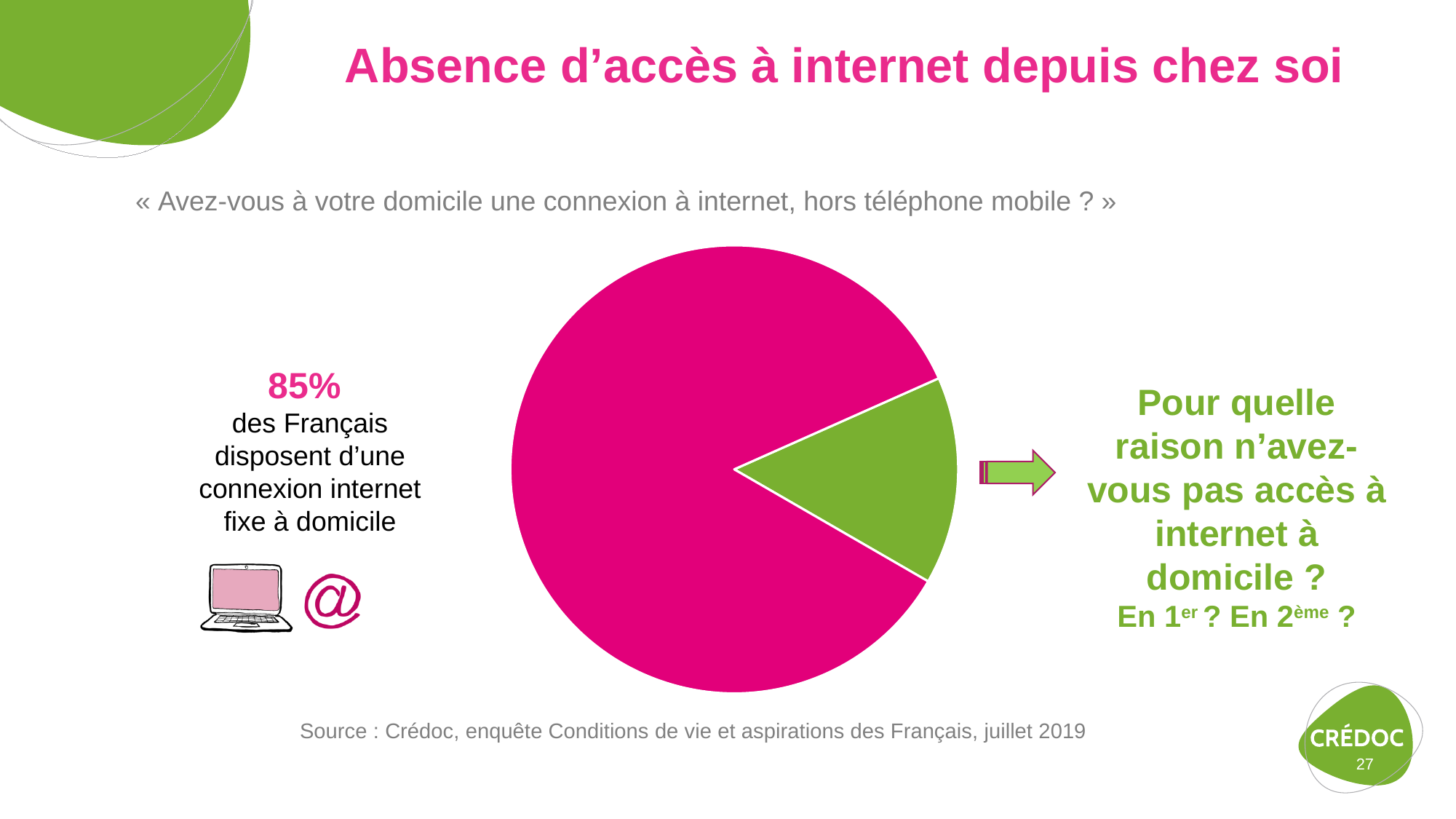
Which slice of the pie chart is the smallest? the green slice Which slice of the pie chart represents the French who have a fixed internet connection at home? the pink slice How many slices does the pie chart have? 2 What kind of chart is shown on the slide? pie chart What colour is the slice representing people without internet access at home? green Which slice of the pie chart is larger, the pink one or the green one? the pink one According to the slide, what share of French people have a fixed internet connection at home? 85%